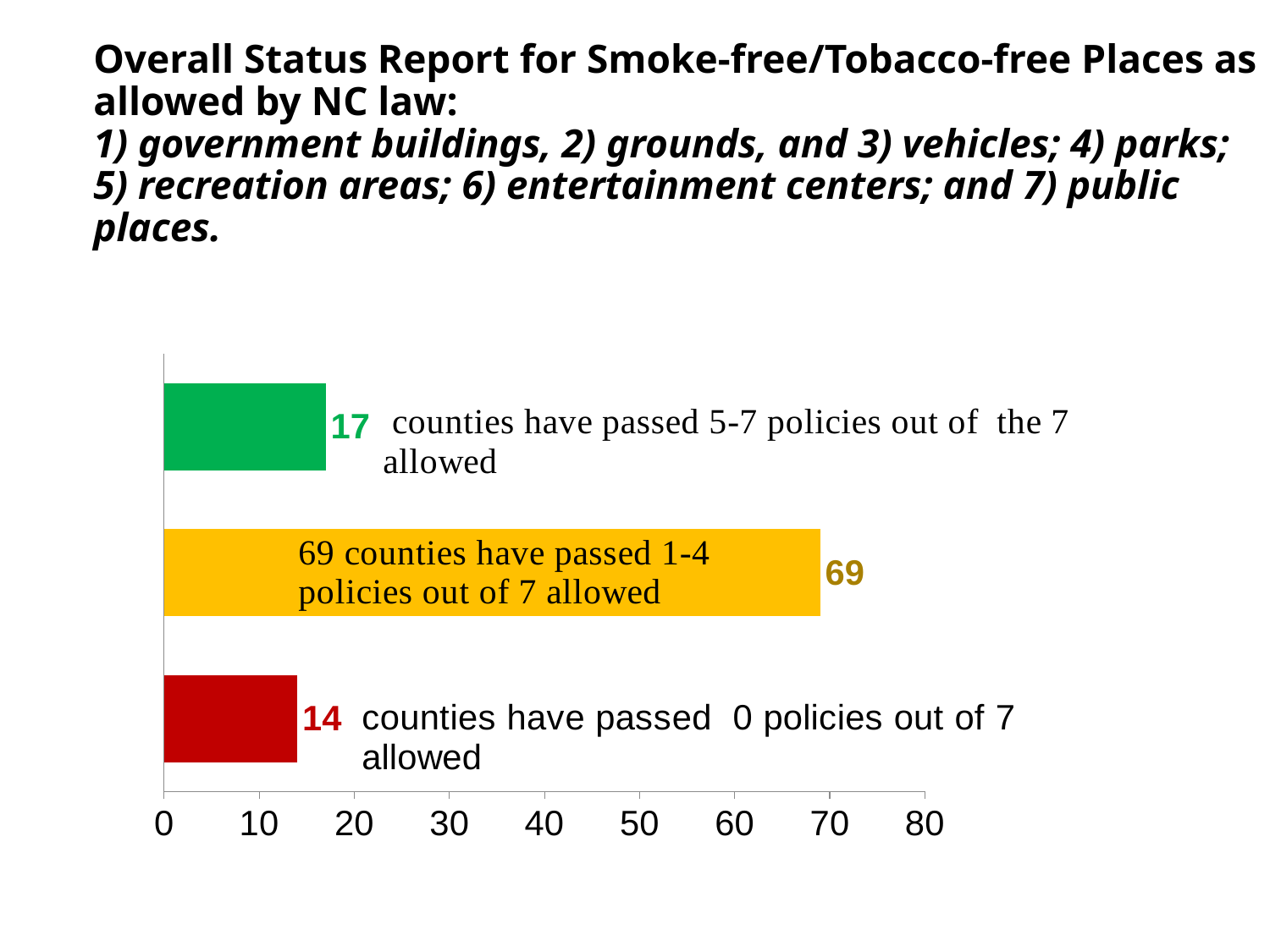
What is the difference between the number of counties that passed 5-7 policies and the number that passed 0 policies? 3 What kind of chart is shown on the slide? Bar chart How many counties have passed 5-7 policies out of the 7 allowed? 17 Which group of counties has the smallest bar? Counties that have passed 0 policies Which is larger: the number of counties that passed 5-7 policies or the number that passed 0 policies? Counties that passed 5-7 policies How many counties have passed 1-4 policies out of 7 allowed? 69 How many counties have passed 0 policies out of 7 allowed? 14 What is the difference between the number of counties that passed 1-4 policies and the number that passed 5-7 policies? 52 Which group of counties has the largest bar? Counties that have passed 1-4 policies How many bars are shown in the chart? 3 What colour is the bar for counties that have passed 0 policies? Red Is the value for counties that passed 1-4 policies greater or less than 60? greater